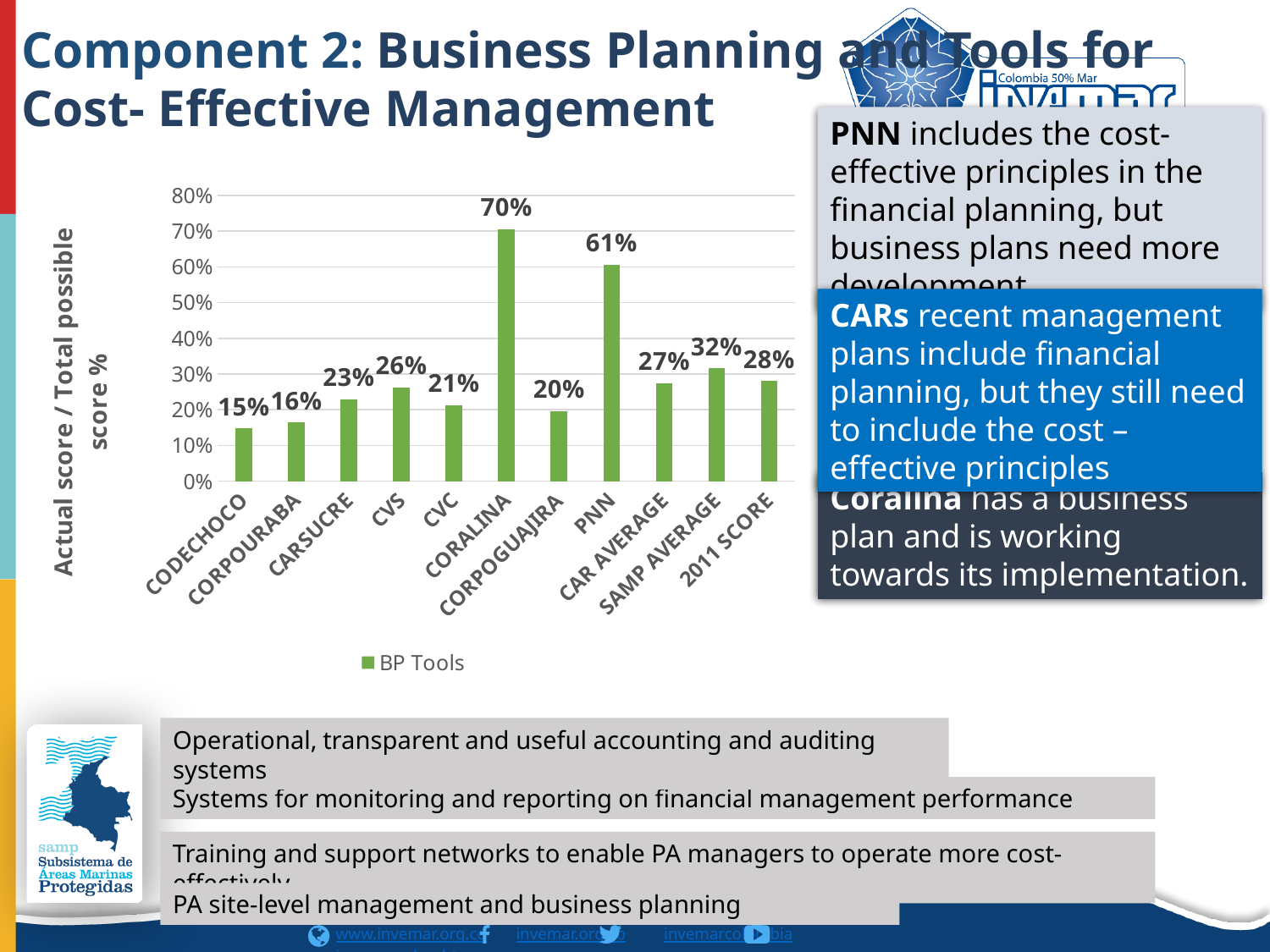
How many series does the legend list? 1 Which is larger, the value for CVS or the value for CVC? CVS How many categories are shown on the x axis? 11 What is the legend entry for the series? BP Tools Which category has the lowest value? CODECHOCO What is the difference between the values for CORALINA and PNN? 9% What kind of chart is shown? Bar chart What is the value for CORALINA? 70% What is the value for PNN? 61% What is the value for SAMP AVERAGE? 32% What is the value for CODECHOCO? 15% Which category has the highest value? CORALINA